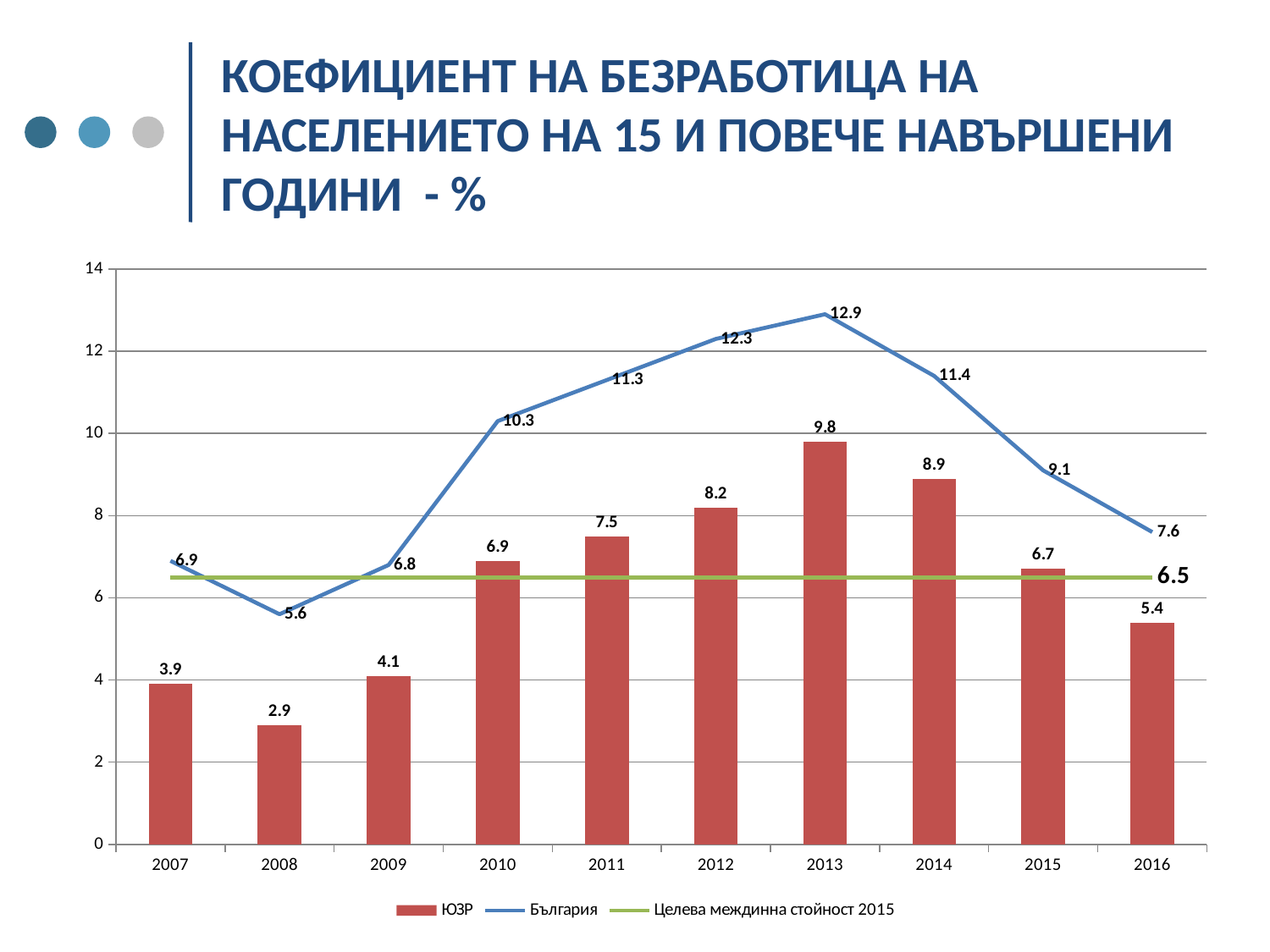
In which year is the България value highest? 2013 In which year is the ЮЗР value highest? 2013 Which is larger in 2015: the ЮЗР value or the Целева междинна стойност 2015 value? ЮЗР What is the value for ЮЗР in 2013? 9.8 How many series does the legend list? 3 What is the difference between the България and ЮЗР values in 2016? 2.2 In which year is the ЮЗР value lowest? 2008 What is the value of the Целева междинна стойност 2015 line? 6.5 How many years are shown on the x axis? 10 What kind of chart is shown on the slide? Combined bar and line chart What is the value for България in 2010? 10.3 Does the България value rise or fall from 2013 to 2016? Fall